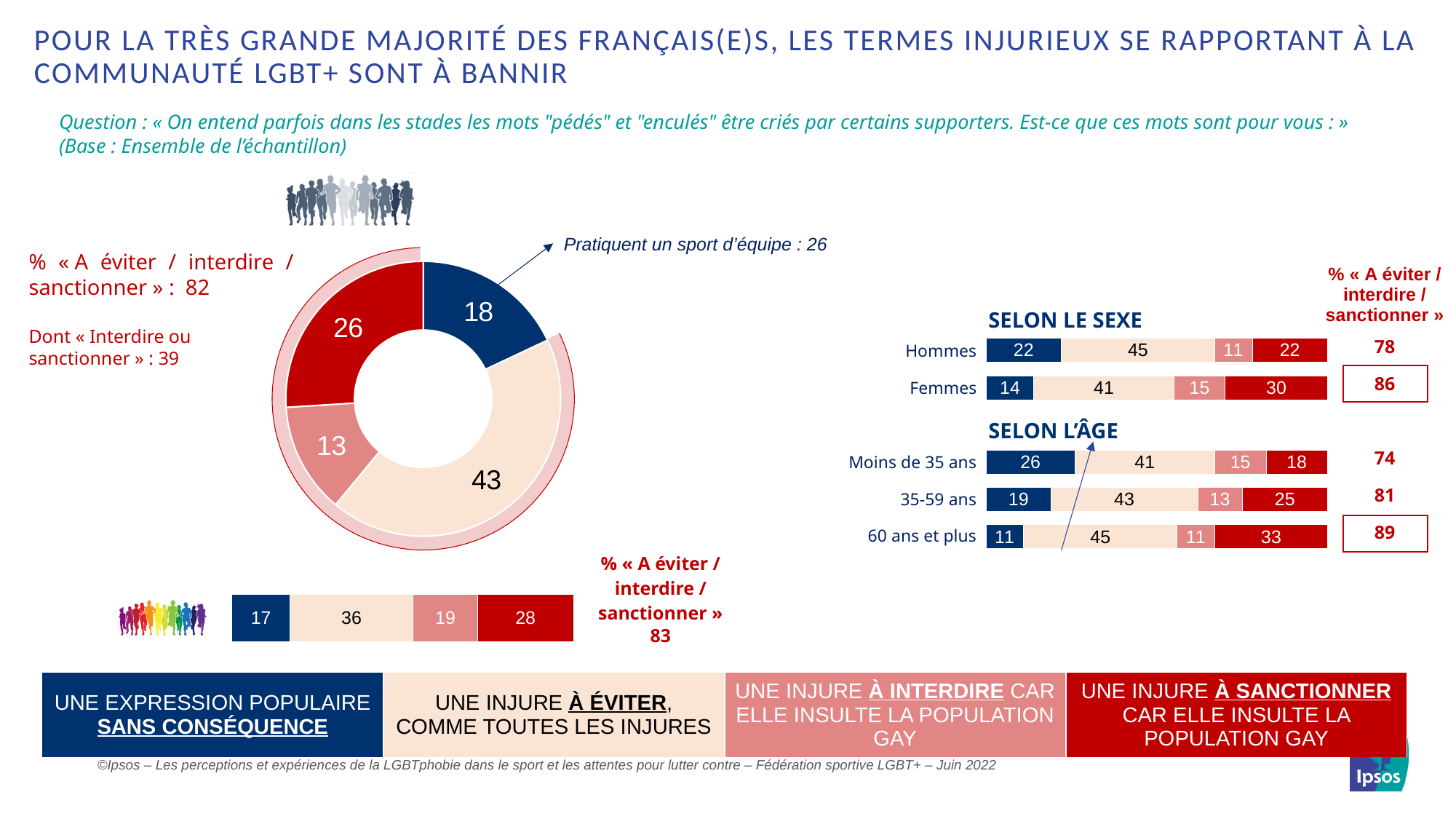
In the SELON L'ÂGE chart, what is the value of the dark blue 'sans conséquence' segment for Moins de 35 ans? 26 In the donut chart, which response category has the smallest share? Une injure à interdire car elle insulte la population gay (13) In the SELON LE SEXE chart, what is the value for Femmes in the dark red 'à sanctionner' segment? 30 In the donut chart, which response category has the largest share? Une injure à éviter, comme toutes les injures (43) In the SELON L'ÂGE chart, is the 'sans conséquence' value larger for 35-59 ans or for 60 ans et plus? 35-59 ans In the stacked bar at the bottom left (rainbow figures), what is the value of the 'à interdire' (light red) segment? 19 In the SELON L'ÂGE chart, which age group has the highest '% A éviter / interdire / sanctionner' total? 60 ans et plus (89) In the donut chart, what percentage of respondents consider the words 'une injure à sanctionner car elle insulte la population gay' (dark red segment)? 26 In the SELON LE SEXE chart, what is the '% A éviter / interdire / sanctionner' total for Hommes? 78 In the SELON LE SEXE chart, what is the difference between the 'à sanctionner' values for Femmes and Hommes? 8 How many response categories does the legend at the bottom of the slide list? 4 How many age groups are shown in the SELON L'ÂGE chart? 3